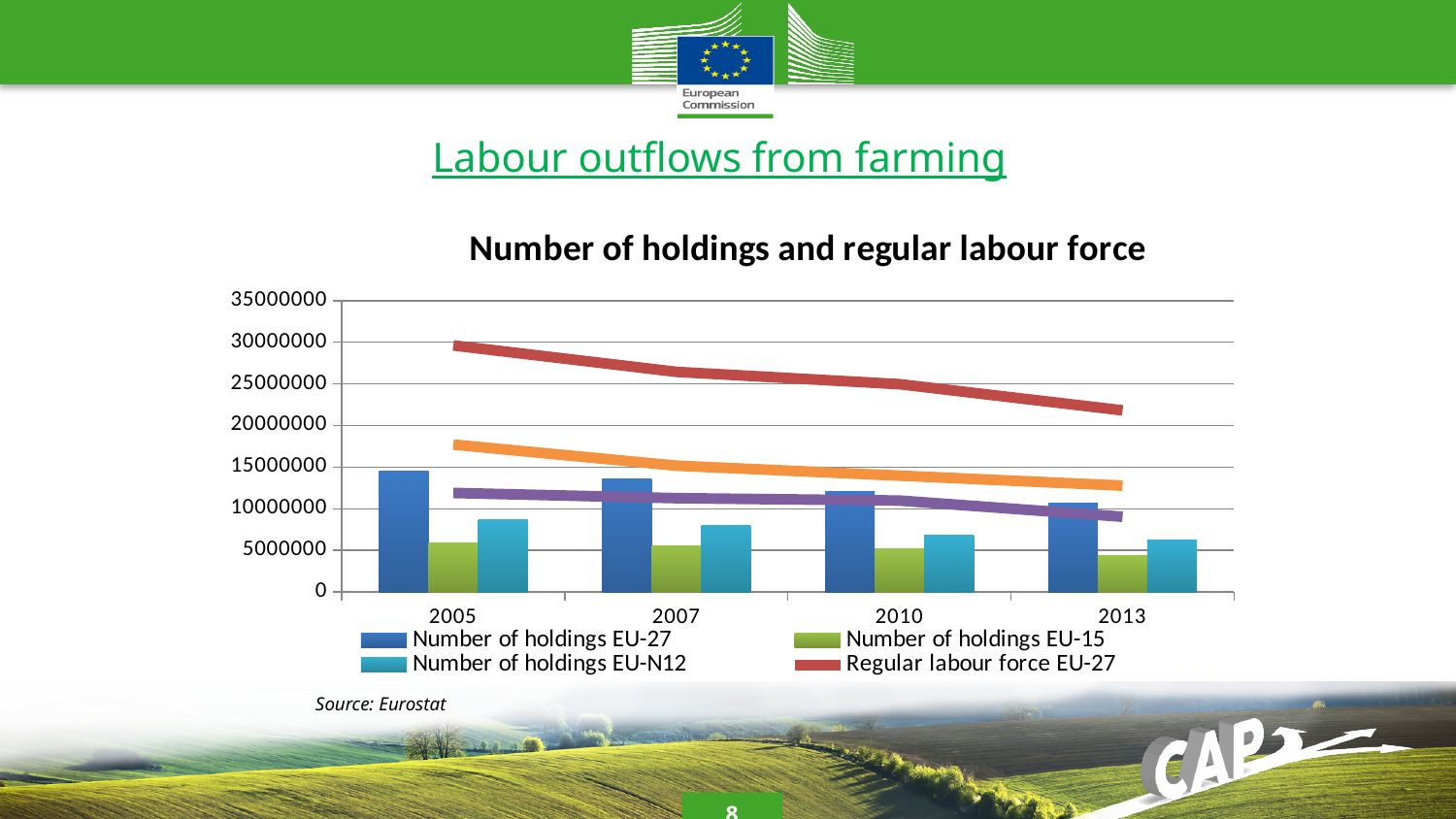
How many years are shown on the x axis of the chart? 4 What is the title of the chart? Number of holdings and regular labour force How many series does the chart legend list? 4 Do the 'Number of holdings EU-27' bars rise or fall from 2005 to 2013? Fall In 2005, which is larger: 'Number of holdings EU-15' or 'Number of holdings EU-N12'? Number of holdings EU-N12 Does the 'Regular labour force EU-27' line rise or fall from 2005 to 2013? Fall Is the value for 'Regular labour force EU-27' in 2013 greater or less than 25000000? less Is the value for 'Number of holdings EU-27' in 2005 greater or less than 10000000? greater In which year is 'Number of holdings EU-27' highest? 2005 In which year is 'Number of holdings EU-27' lowest? 2013 Is the value for 'Regular labour force EU-27' in 2005 greater or less than 25000000? greater What kind of chart is used for the 'Number of holdings' series? Bar chart